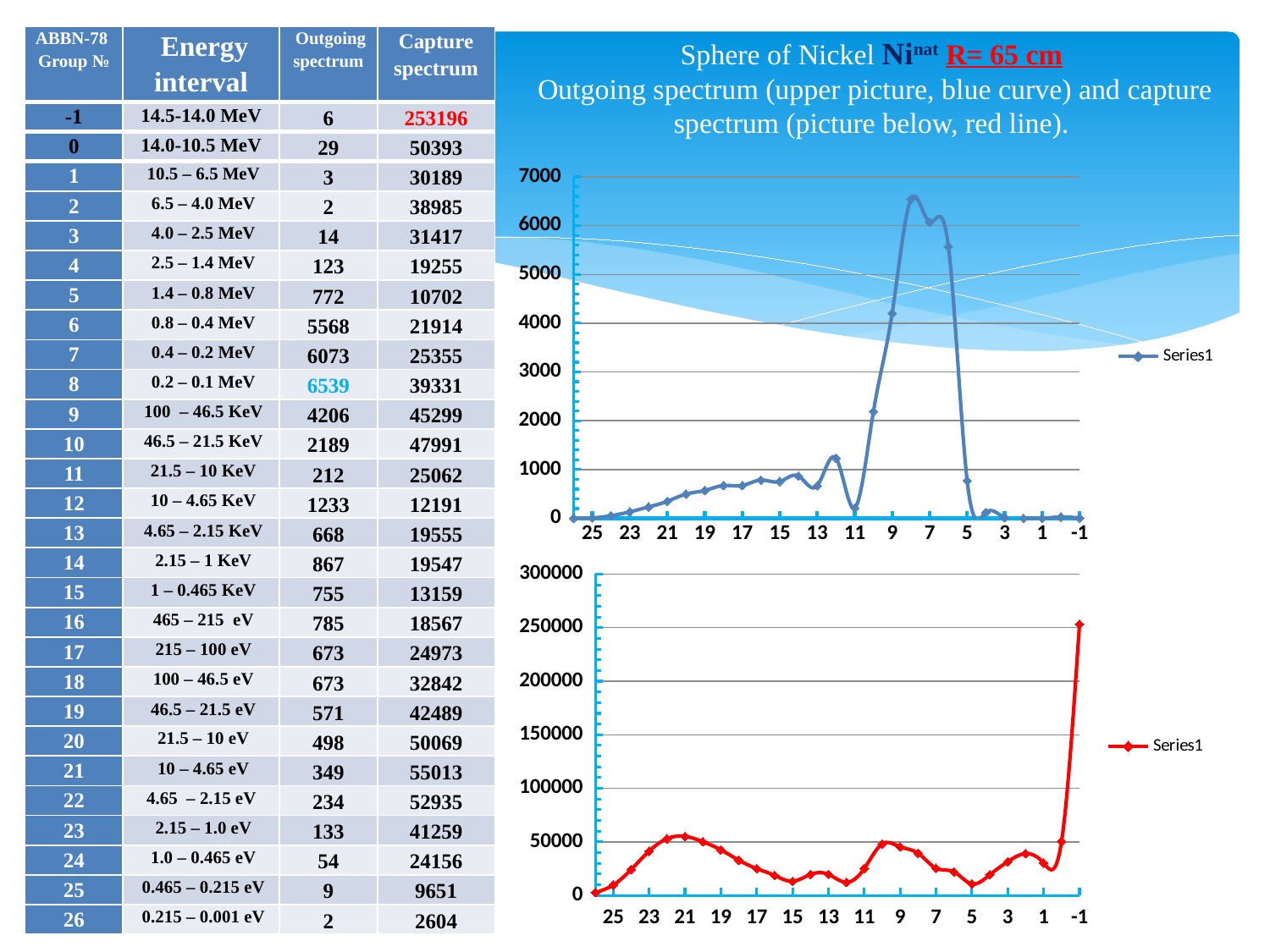
In the lower picture (capture spectrum), is the value at group 5 greater or less than 50000? less In the upper picture (outgoing spectrum), is the value at group 11 greater or less than 1000? less What kind of chart is the upper picture (blue curve) on the slide? line chart In the lower picture (capture spectrum), is the value at group -1 greater or less than 200000? greater In the lower picture (capture spectrum), at which group number on the x axis does the red line reach its highest value? -1 In the upper picture (outgoing spectrum), at which group number on the x axis does the blue curve reach its highest value? 8 According to the table, what is the outgoing spectrum value for group 8, the peak of the upper blue curve? 6539 In the upper picture (outgoing spectrum), does the blue curve rise or fall going from group 8 to group 5 along the x axis? fall According to the table, what is the capture spectrum value for group -1, the peak of the lower red line? 253196 What is the legend entry shown next to the upper blue chart? Series1 How many series does the legend of the lower picture (red line) list? 1